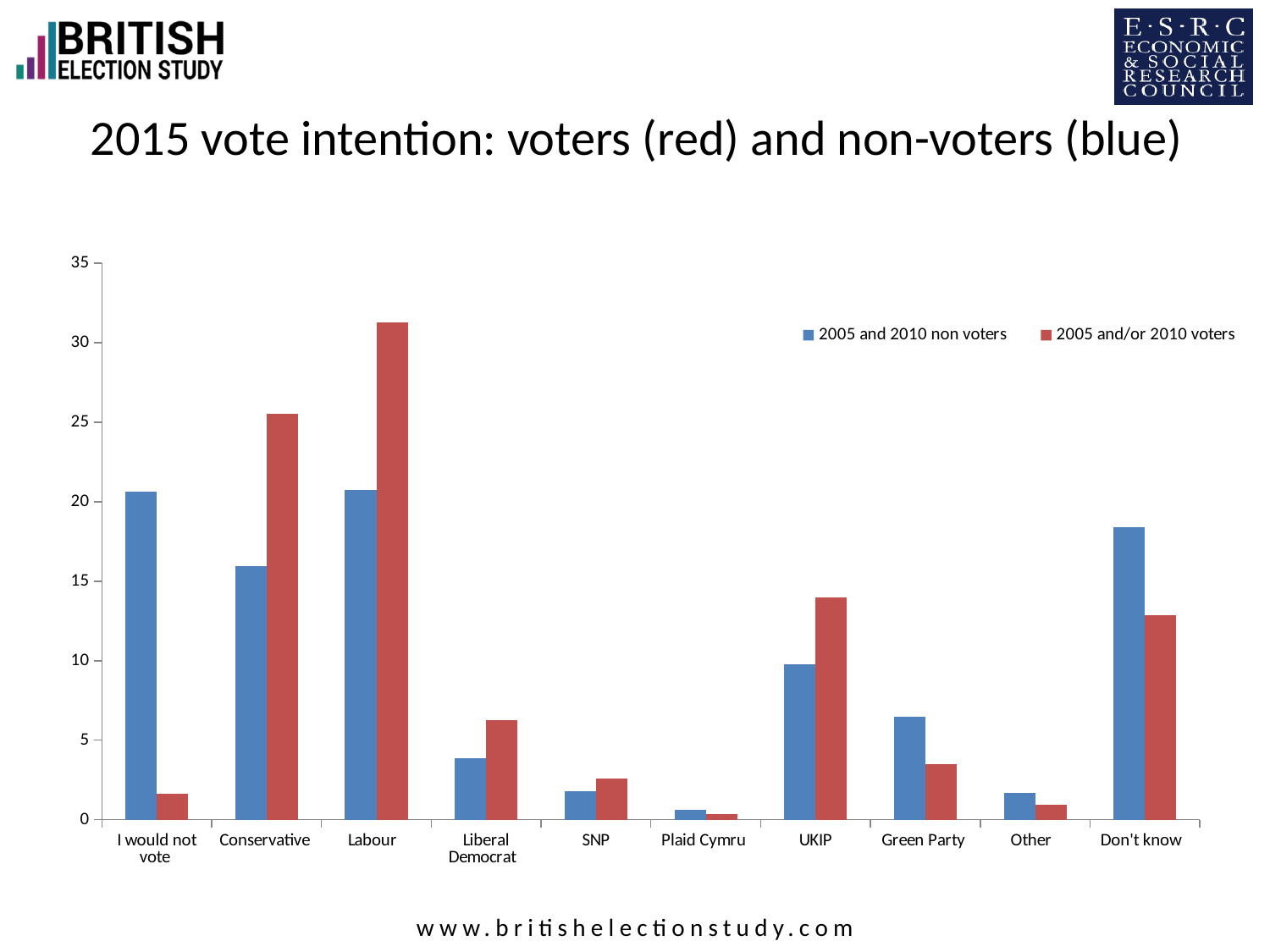
Is the value for UKIP in the 2005 and/or 2010 voters series greater or less than 10? greater Is the value for I would not vote in the 2005 and/or 2010 voters series greater or less than 5? less Which category has the lowest value for the 2005 and/or 2010 voters series? Plaid Cymru Is the value for Don't know in the 2005 and 2010 non voters series greater or less than 15? greater For Conservative, which series has the larger value: 2005 and 2010 non voters or 2005 and/or 2010 voters? 2005 and/or 2010 voters Which category has the highest value for the 2005 and/or 2010 voters series? Labour How many series does the legend list? 2 Which colour represents the 2005 and 2010 non voters series? blue What kind of chart is shown on the slide? bar chart How many categories are shown on the x axis? 10 For Green Party, which series has the larger value: 2005 and 2010 non voters or 2005 and/or 2010 voters? 2005 and 2010 non voters